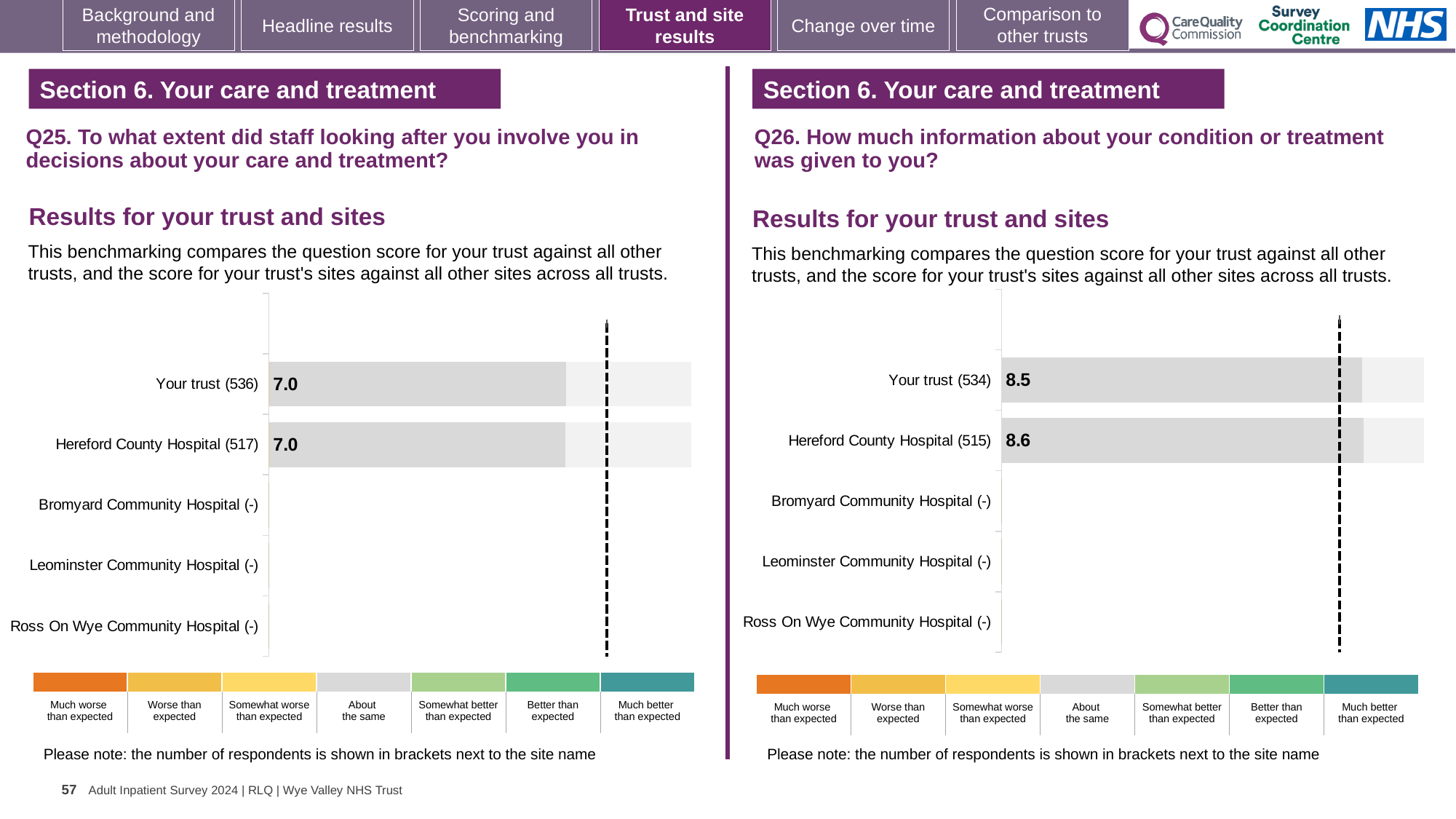
In the Q26 chart on the right, what is the difference between the Hereford County Hospital score and the Your trust score? 0.1 In the Q26 chart on the right, what is the score for Your trust (534)? 8.5 In the Q25 chart on the left, how many sites or categories are listed on the vertical axis? 5 In the Q26 chart on the right, how many respondents are shown in brackets for Hereford County Hospital? 515 In the Q25 chart on the left, how many benchmark categories are shown in the colour key below the chart? 7 In the Q26 chart on the right, what is the score for Hereford County Hospital (515)? 8.6 In the Q25 chart on the left, what is the score for Your trust (536)? 7.0 In the Q25 chart on the left, how many respondents are shown in brackets for Your trust? 536 In the Q26 chart on the right, which has the higher score: Your trust or Hereford County Hospital? Hereford County Hospital In the Q26 chart on the right, which benchmark category in the colour key is shown in orange? Much worse than expected In the Q25 chart on the left, what is the score for Hereford County Hospital (517)? 7.0 What type of chart is used in the Q26 chart on the right? Bar chart